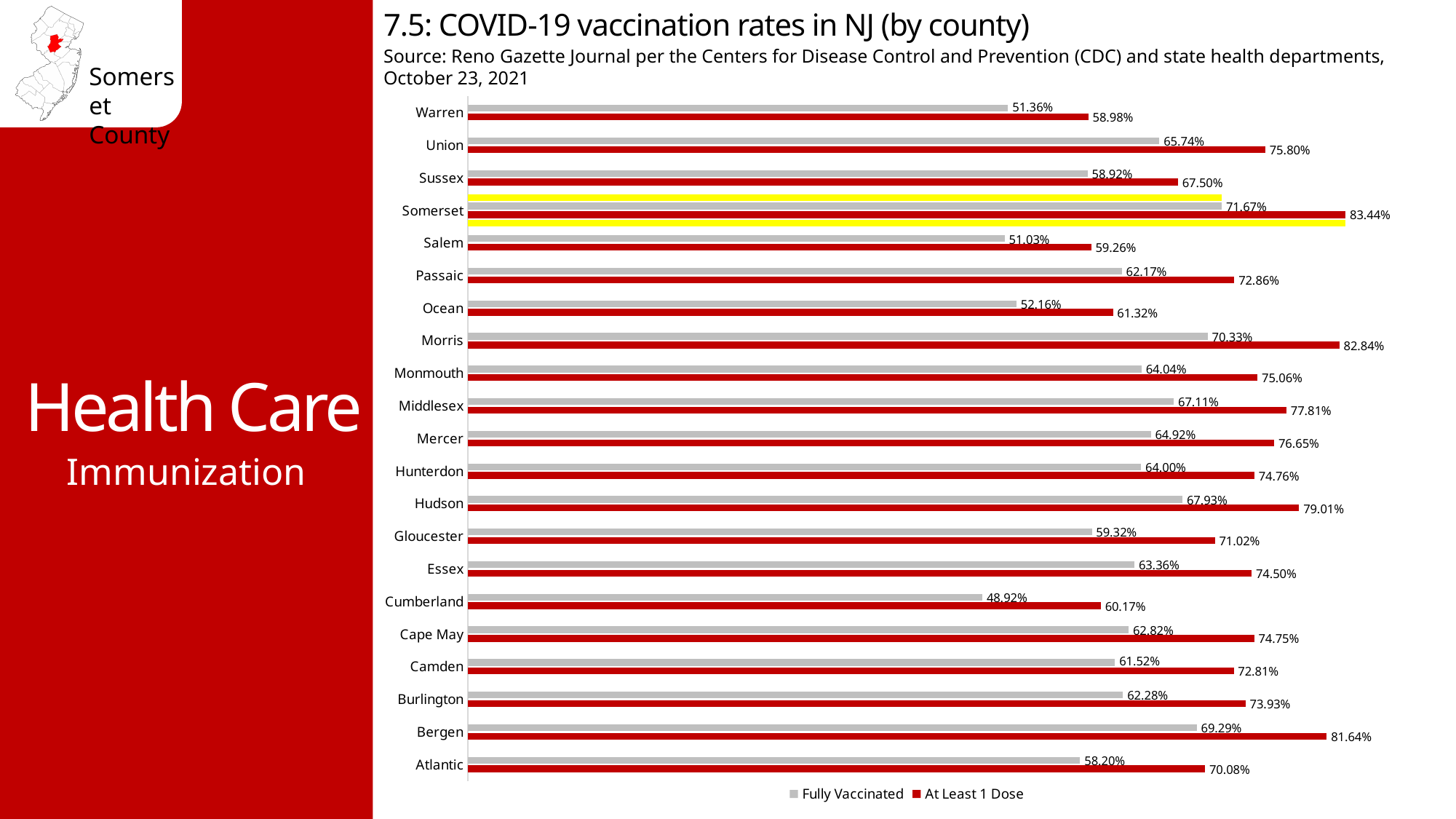
How many counties are shown in the chart? 21 Which county has the lowest At Least 1 Dose rate? Warren How many series does the legend list? 2 What is the At Least 1 Dose rate for Bergen county? 81.64% What is the difference between the At Least 1 Dose rate and the Fully Vaccinated rate for Somerset county? 11.77 percentage points Which county has the lowest Fully Vaccinated rate? Cumberland What type of chart is shown on the slide? Bar chart Which county has the highest At Least 1 Dose rate? Somerset Which county's bars are highlighted in yellow on the chart? Somerset What is the Fully Vaccinated rate for Cumberland county? 48.92% Which county has a higher At Least 1 Dose rate, Morris or Bergen? Morris What is the Fully Vaccinated rate for Somerset county? 71.67%